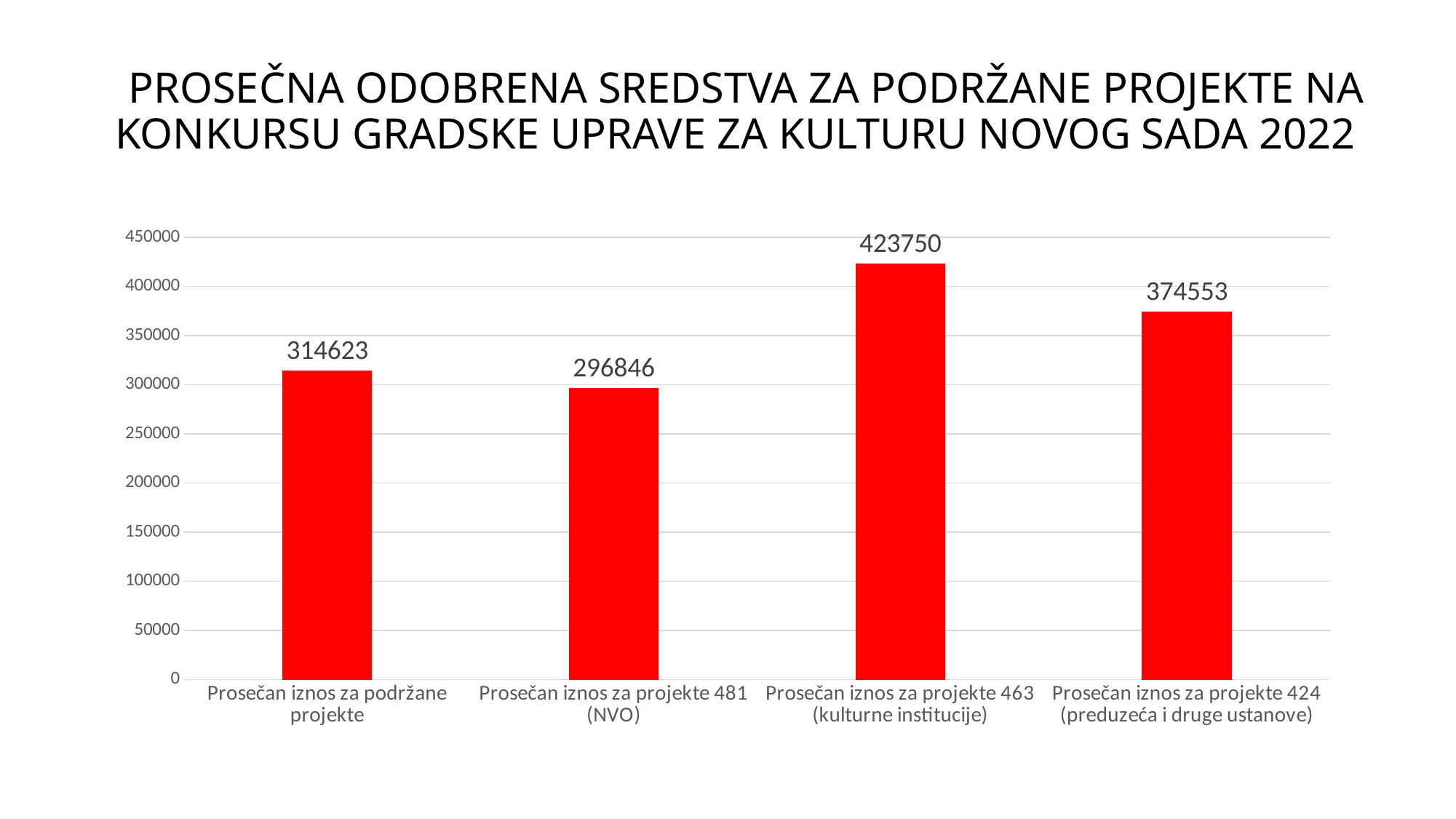
What is the value for 'Prosečan iznos za podržane projekte'? 314623 Which category has the lowest value? Prosečan iznos za projekte 481 (NVO) What value is shown for 'Prosečan iznos za projekte 463 (kulturne institucije)'? 423750 Which is larger: the value for 'Prosečan iznos za projekte 424 (preduzeća i druge ustanove)' or the value for 'Prosečan iznos za podržane projekte'? Prosečan iznos za projekte 424 (preduzeća i druge ustanove) Is the value for 'Prosečan iznos za projekte 481 (NVO)' greater or less than 300000? less What is the average amount for 'Prosečan iznos za projekte 481 (NVO)'? 296846 What is the difference between the value for 'Prosečan iznos za projekte 424 (preduzeća i druge ustanove)' and the value for 'Prosečan iznos za podržane projekte'? 59930 How many categories are shown in the chart? 4 Which category has the highest value? Prosečan iznos za projekte 463 (kulturne institucije) What is the difference between the value for 'Prosečan iznos za projekte 463 (kulturne institucije)' and the value for 'Prosečan iznos za projekte 481 (NVO)'? 126904 What value is shown for 'Prosečan iznos za projekte 424 (preduzeća i druge ustanove)'? 374553 What type of chart is shown on the slide? bar chart